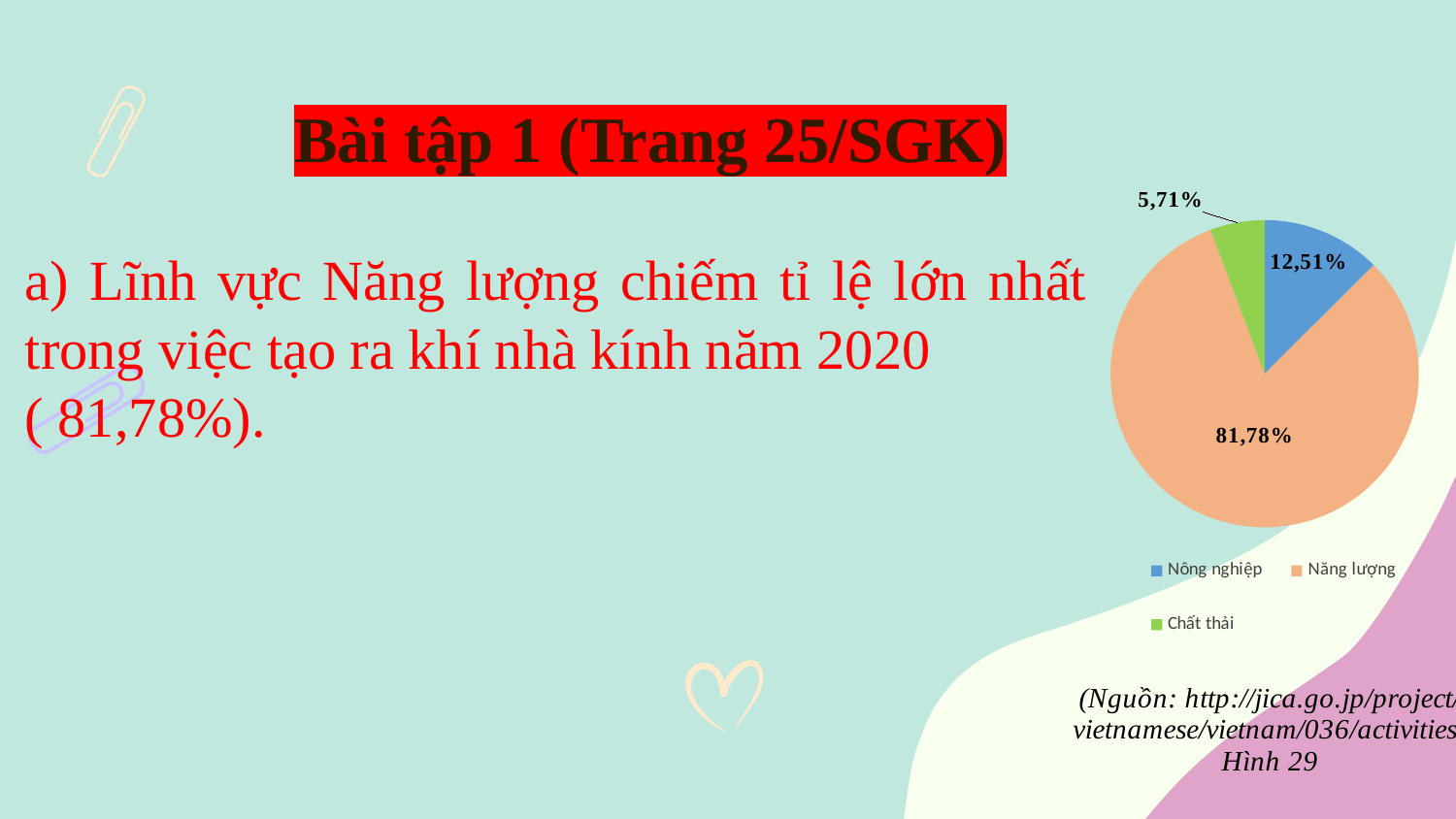
Which category has the smallest slice of the pie? Chất thải Which is larger, the slice for Nông nghiệp or the slice for Chất thải? Nông nghiệp What is the difference in percentage points between the Nông nghiệp slice and the Chất thải slice? 6,8 How many slices does the pie chart have? 3 What share of the pie does Năng lượng have? 81,78% What is the difference in percentage points between the Năng lượng slice and the Nông nghiệp slice? 69,27 How many entries does the legend list? 3 Which category has the largest slice of the pie? Năng lượng What share of the pie does Nông nghiệp have? 12,51% What share of the pie does Chất thải have? 5,71% What kind of chart is shown on the slide? pie chart Which colour represents Chất thải in the pie chart? green